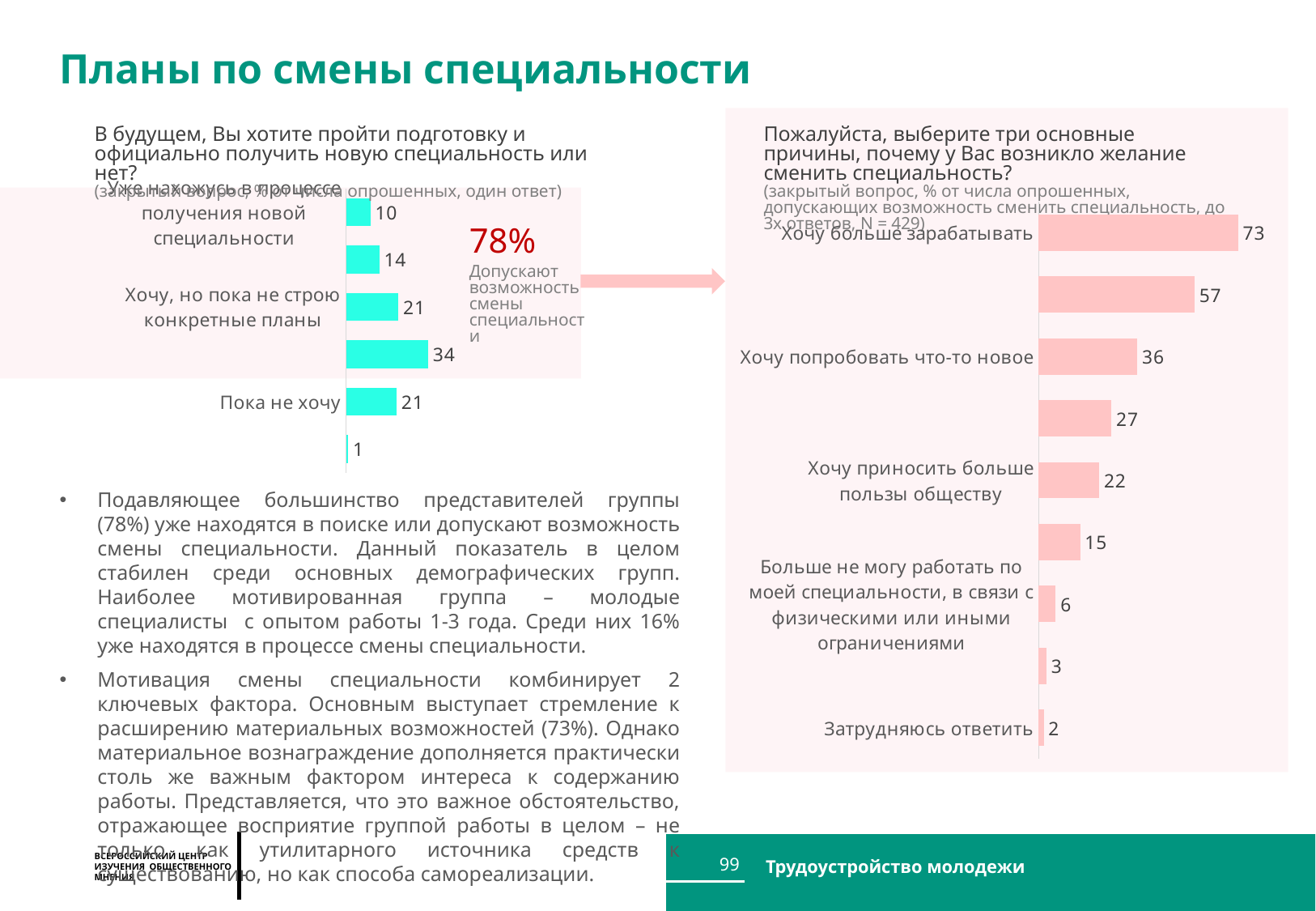
In the right chart (reasons for wanting to change specialty), what is the value for "Хочу больше зарабатывать"? 73 In the right chart, what is the value for "Затрудняюсь ответить"? 2 In the right chart, what is the difference between "Хочу больше зарабатывать" and "Хочу попробовать что-то новое"? 37 In the right chart, how many bars are plotted? 9 In the right chart, what is the value for "Хочу приносить больше пользы обществу"? 22 What kind of chart is the right chart? Bar chart In the left chart (plans to get a new specialty), what is the value for "Пока не хочу"? 21 In the right chart, what is the value for "Хочу попробовать что-то новое"? 36 In the left chart, what is the value for "Уже нахожусь в процессе получения новой специальности"? 10 In the right chart, which category has the highest value? Хочу больше зарабатывать In the left chart, what is the largest value shown on any bar? 34 In the left chart, what is the value for "Хочу, но пока не строю конкретные планы"? 21